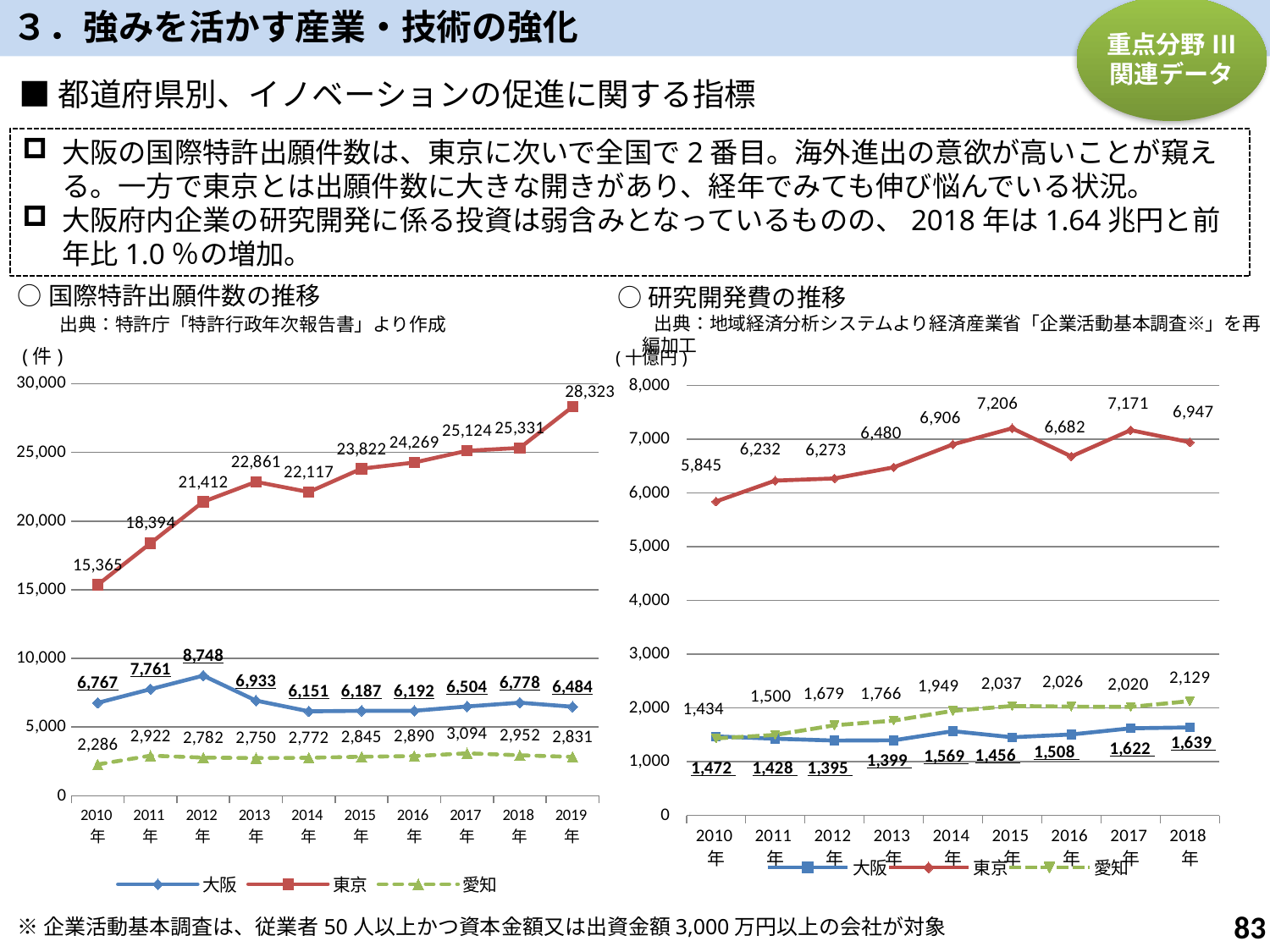
In the 国際特許出願件数の推移 chart, how many series does the legend list? 3 In the 研究開発費の推移 chart, which is larger in 2018年, 愛知 or 大阪? 愛知 In the 研究開発費の推移 chart, what is the difference between 東京 in 2018年 and 東京 in 2010年? 1,102 In the 研究開発費の推移 chart, what is the value for 大阪 in 2018年? 1,639 In the 国際特許出願件数の推移 chart, how many years are shown on the x axis? 10 In the 国際特許出願件数の推移 chart, what is the value for 大阪 in 2012年? 8,748 In the 国際特許出願件数の推移 chart, what is the difference between 東京 and 大阪 in 2019年? 21,839 In the 国際特許出願件数の推移 chart, in which year does 大阪 reach its highest value? 2012年 In the 研究開発費の推移 chart, in which year does 東京 reach its highest value? 2015年 In the 研究開発費の推移 chart, what is the lowest value for 大阪? 1,395 In the 国際特許出願件数の推移 chart, what is the value for 東京 in 2019年? 28,323 What kind of chart is the 研究開発費の推移 chart? line chart